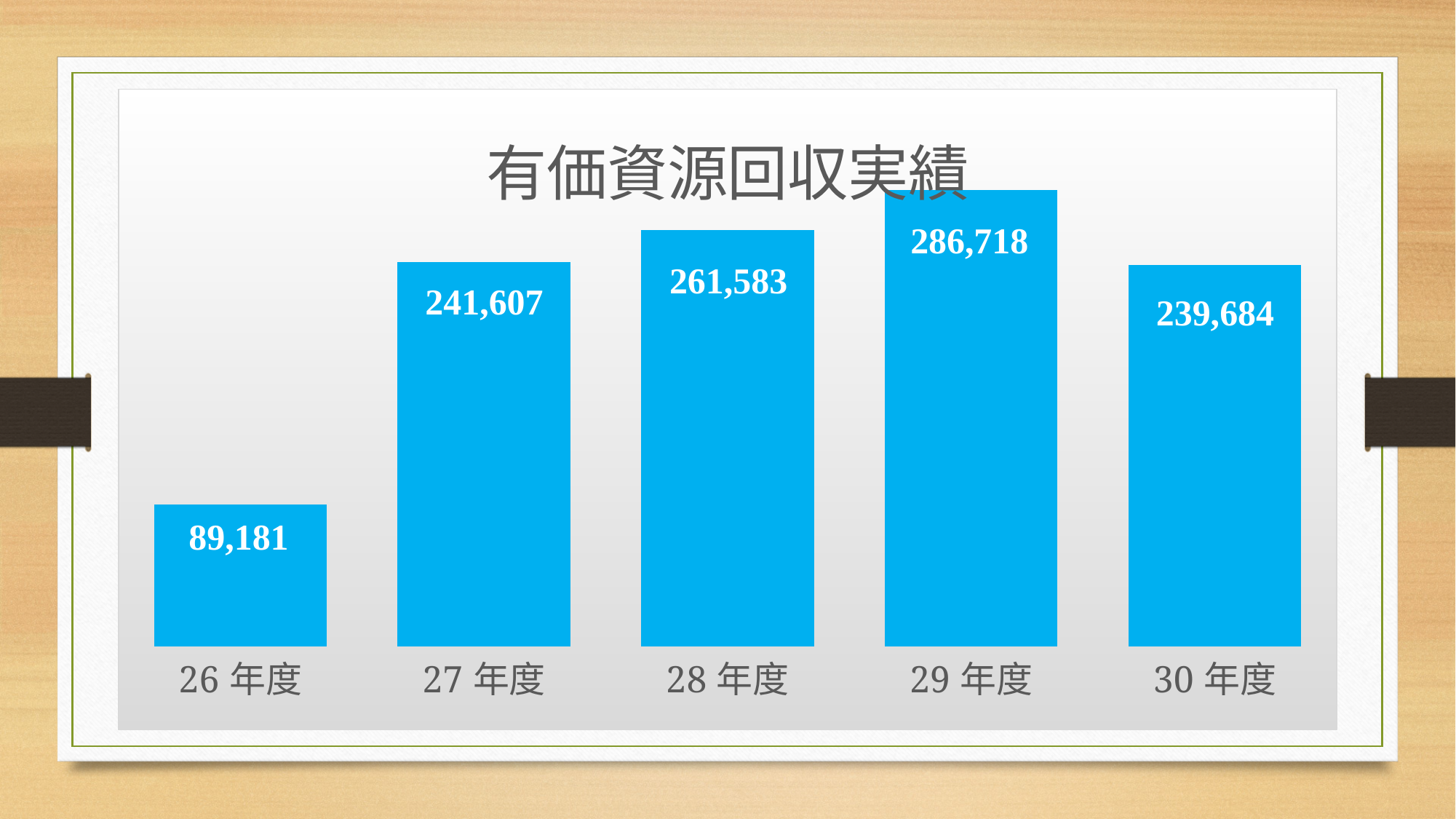
How many years are shown on the chart? 5 What is the difference between the values for 29 年度 and 28 年度? 25,135 Which year has the lowest value? 26 年度 What is the difference between the values for 27 年度 and 26 年度? 152,426 What is the value for 30 年度? 239,684 What kind of chart is this? bar chart Does the value rise or fall from 29 年度 to 30 年度? fall Which is larger, the value for 27 年度 or the value for 30 年度? 27 年度 Which year has the highest value? 29 年度 What is the title of the chart? 有価資源回収実績 What is the value for 26 年度? 89,181 What is the value for 29 年度? 286,718